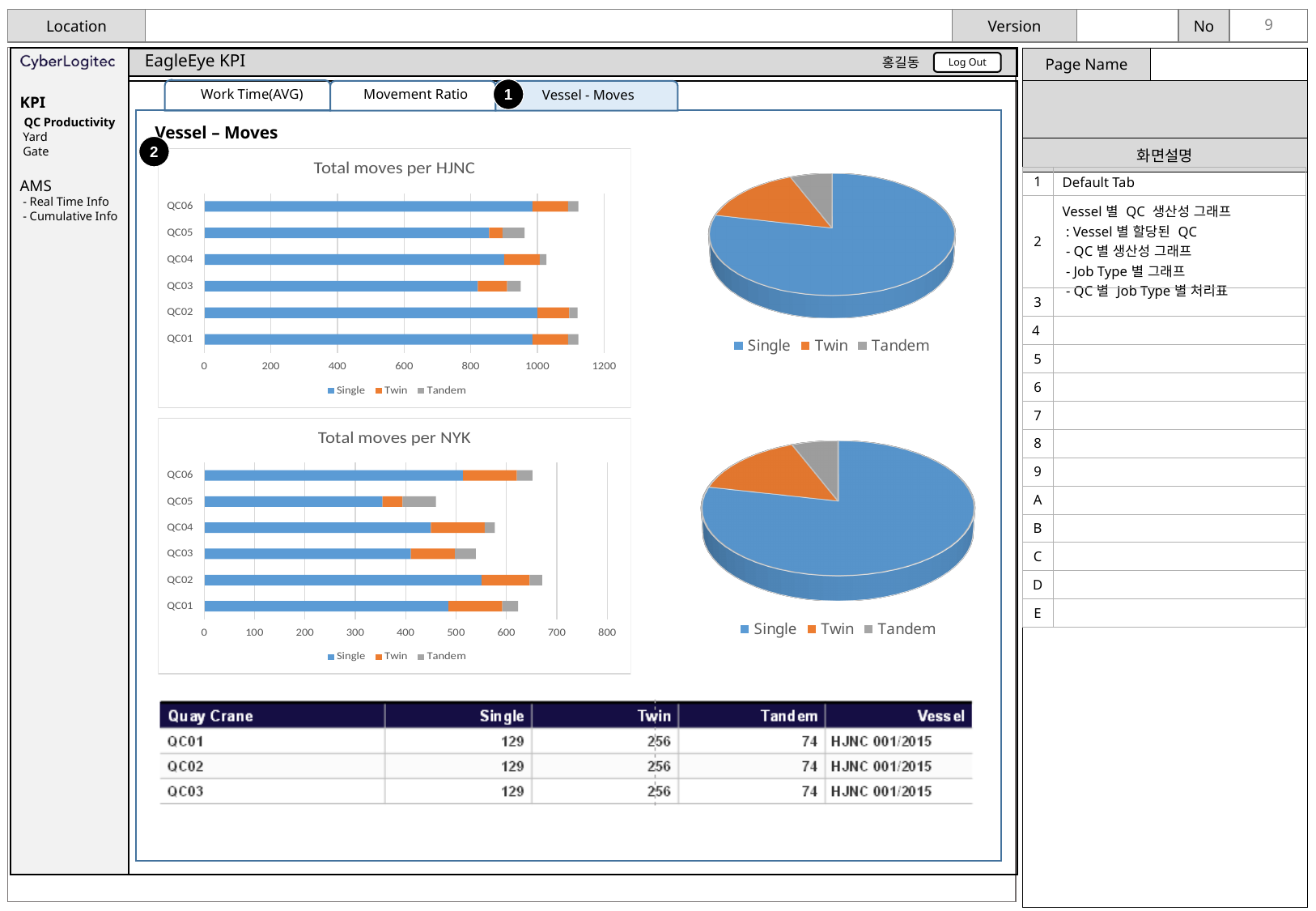
In the "Total moves per HJNC" chart, is the total bar length for QC05 greater or less than 1000? less In the "Total moves per NYK" chart, which quay crane has the highest total moves? QC02 How many series does the legend of the "Total moves per HJNC" chart list? 3 In the bottom-right pie chart, which series has the largest slice? Single What kind of chart is "Total moves per HJNC"? bar chart What kind of chart is the top-right chart with the Single, Twin and Tandem legend? pie chart In the "Total moves per NYK" chart, which quay crane has the lowest total moves? QC05 In the "Total moves per HJNC" chart, is the total bar length for QC06 greater or less than 1000? greater In the "Total moves per NYK" chart, is the Single value for QC02 greater or less than 500? greater In the "Total moves per HJNC" chart, which is larger for QC05: the Single segment or the Twin segment? Single How many quay crane categories are shown in the "Total moves per NYK" chart? 6